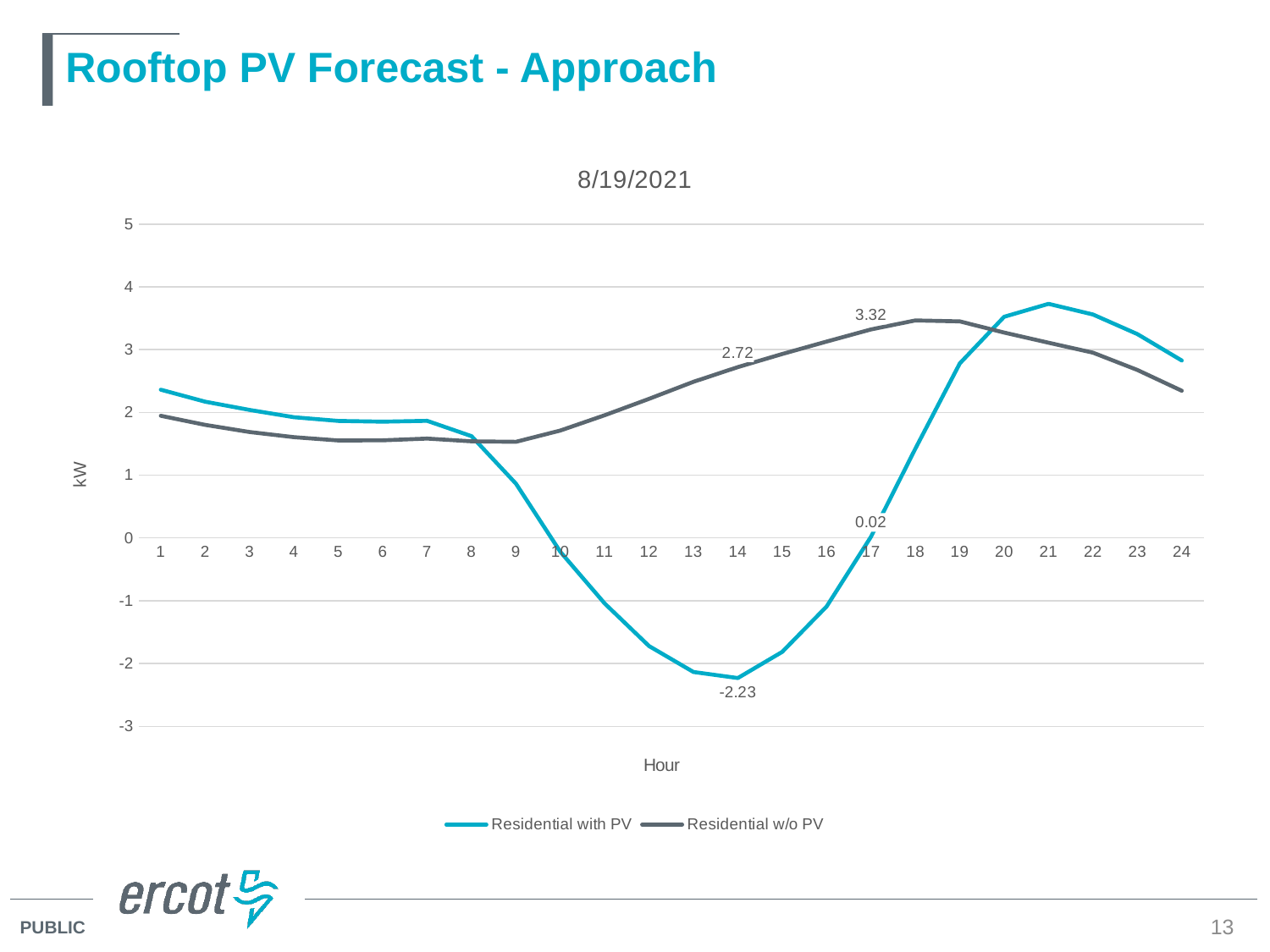
What kind of chart is shown on the slide? Line chart At which hour does the Residential with PV series reach its lowest value? 14 What is the title of the chart? 8/19/2021 Is the value for Residential with PV at hour 21 greater or less than 3? greater At hour 14, what is the difference between the Residential w/o PV value and the Residential with PV value? 4.95 What is the value for Residential w/o PV at hour 17? 3.32 What is the value for Residential with PV at hour 17? 0.02 How many hours are plotted along the x axis? 24 What is the value for Residential with PV at hour 14? -2.23 What is the value for Residential w/o PV at hour 14? 2.72 At hour 17, which series has the larger value, Residential with PV or Residential w/o PV? Residential w/o PV How many series does the legend list? 2